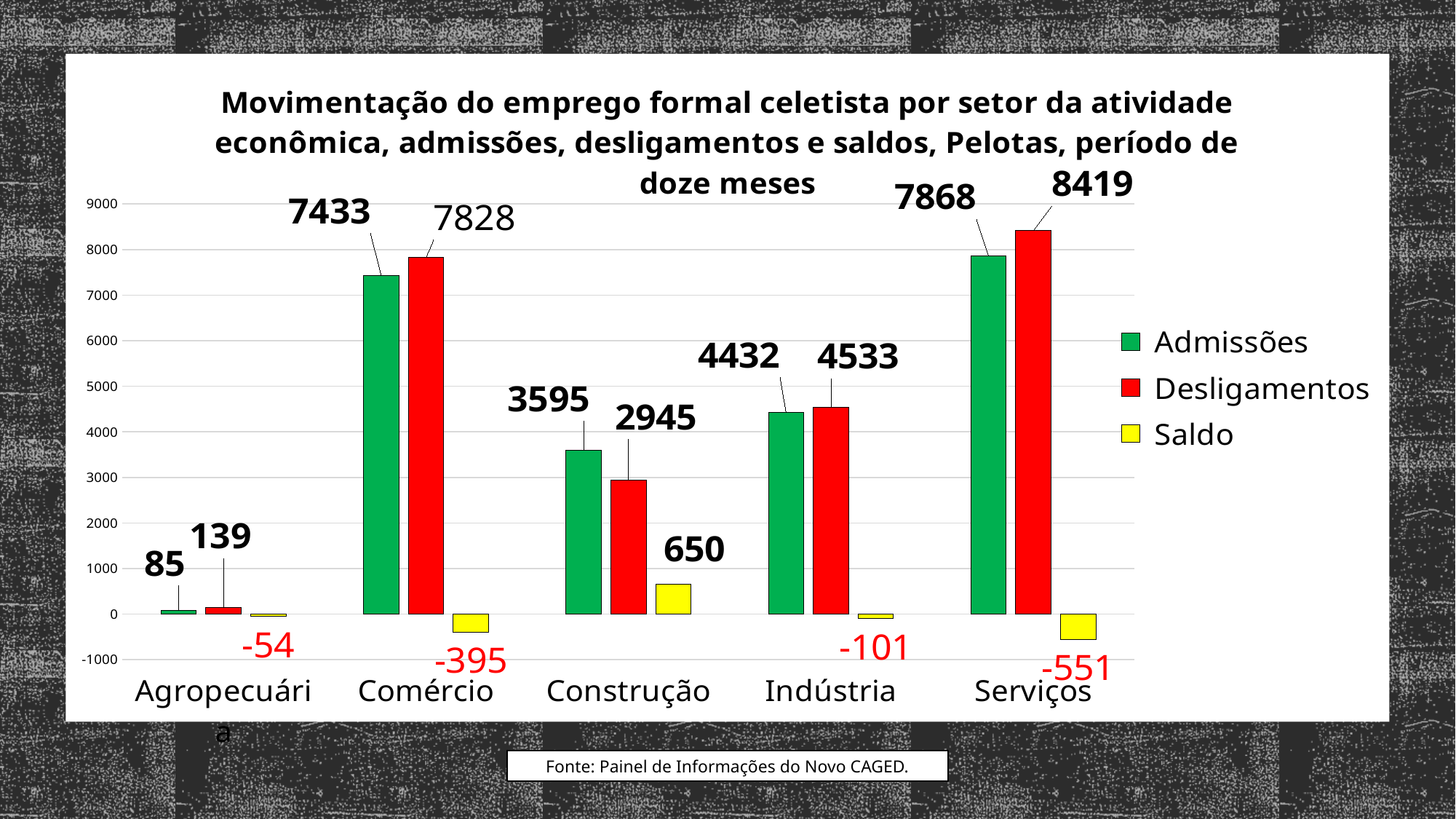
How many series does the legend list? 3 What is the Admissões value for Comércio? 7433 What is the Desligamentos value for Serviços? 8419 What is the difference between Desligamentos and Admissões for Indústria? 101 What colour represents the Saldo series in the legend? Yellow What is the Saldo value for Construção? 650 What kind of chart is shown on the slide? Bar chart What is the Saldo value for Comércio? -395 Which sector has the lowest Desligamentos value? Agropecuária Which is larger for Construção, Admissões or Desligamentos? Admissões How many sectors are shown on the x axis? 5 Which sector has the highest Admissões value? Serviços